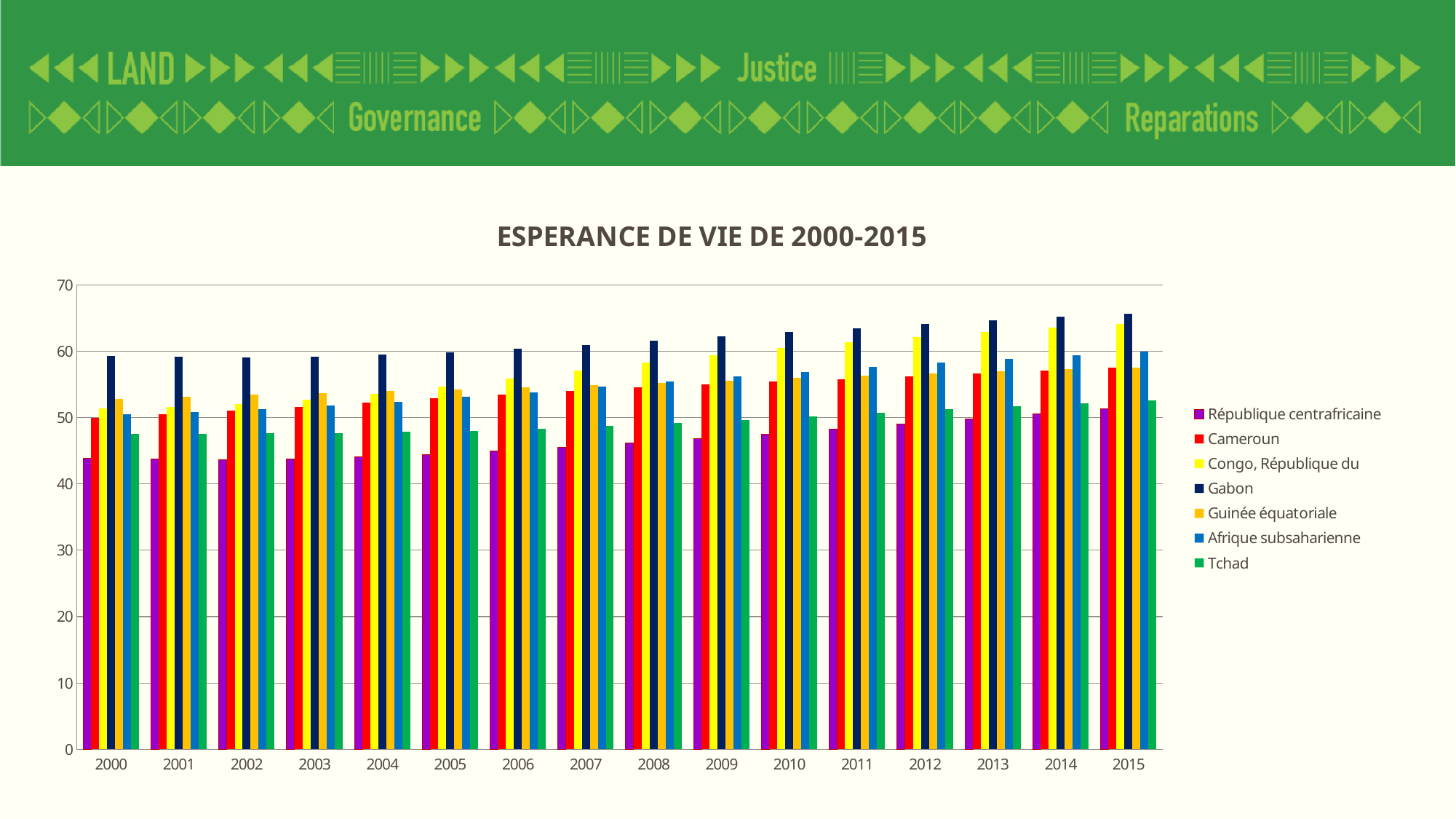
What kind of chart is shown on the slide? bar chart Do the values for Gabon rise or fall from 2000 to 2015? rise Which country has the lowest value in 2000? République centrafricaine Is the value for République centrafricaine in 2000 greater or less than 50? less Is the value for Tchad in 2000 greater or less than 50? less Is the value for Gabon in 2015 greater or less than 60? greater How many years are shown along the x axis? 16 How many series does the legend list? 7 Which colour represents Gabon in the legend? dark navy blue Which is larger in 2010, the value for Gabon or the value for Tchad? Gabon What is the title of the chart? ESPERANCE DE VIE DE 2000-2015 Which country has the highest value in 2015? Gabon